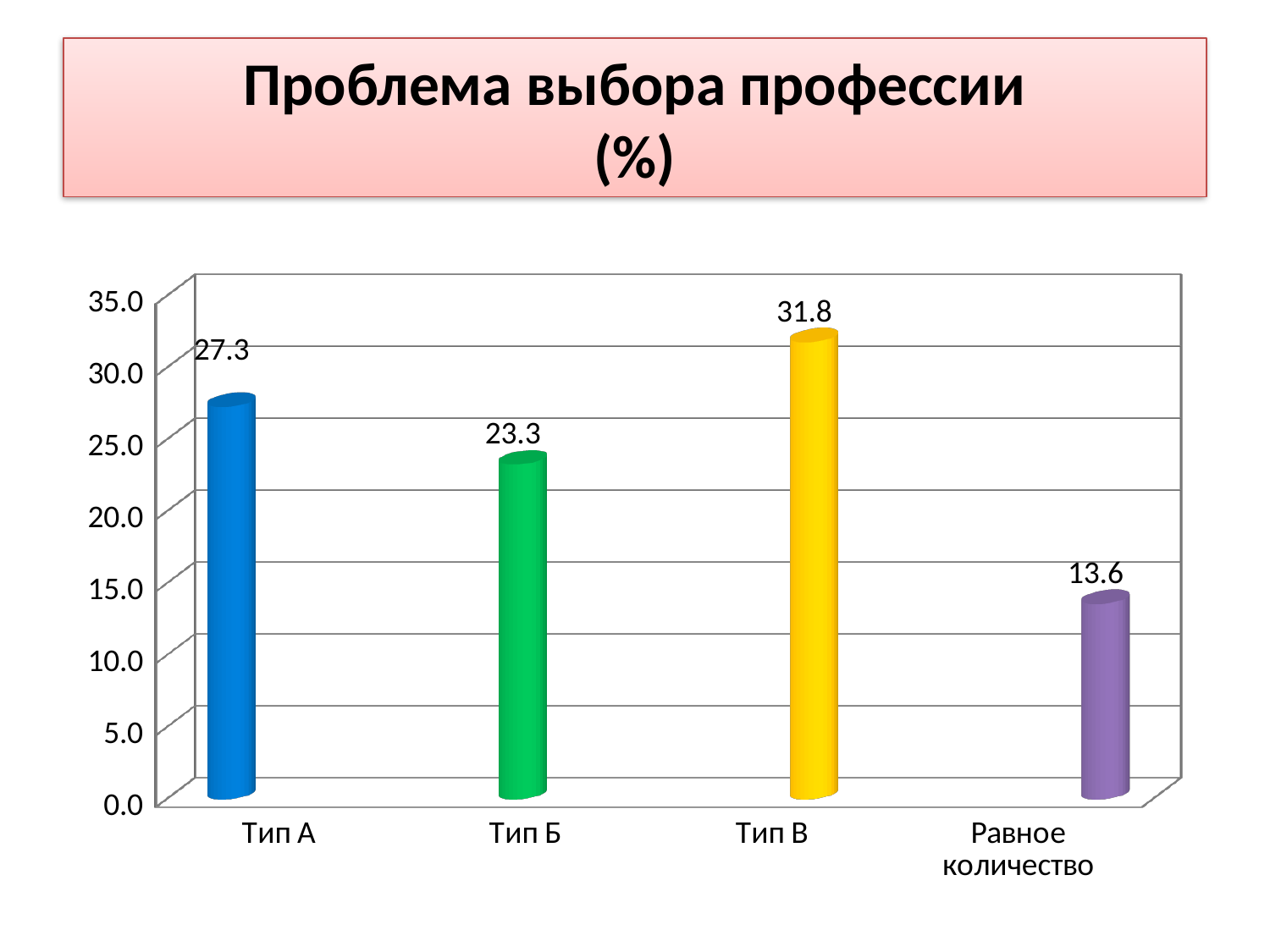
Which category has the highest value? Тип В What is the difference between the values for Тип В and Тип А? 4.5 What is the value for Тип Б? 23.3 What is the difference between the values for Тип Б and Равное количество? 9.7 How many categories are shown on the x axis? 4 What is the value for Тип А? 27.3 What kind of chart is shown on the slide? bar chart Is the value for Тип В greater or less than 30.0? greater Which is larger, the value for Тип А or the value for Тип Б? Тип А What is the value for Тип В? 31.8 What is the value for Равное количество? 13.6 Which category has the lowest value? Равное количество